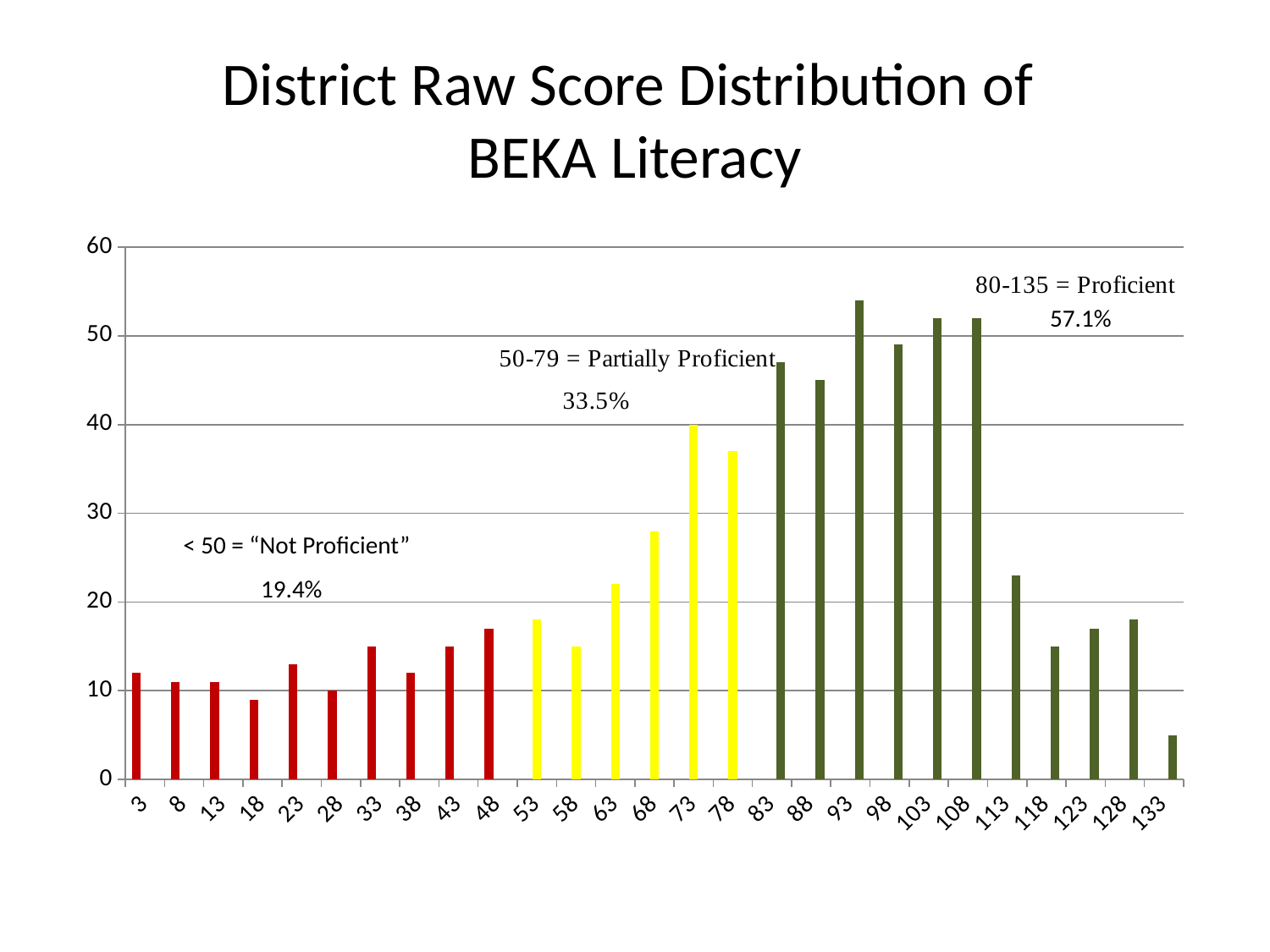
Is the value for score 68 greater or less than 20? greater Is the value for score 133 greater or less than 10? less What type of chart is shown on the slide? bar chart What is the title of the chart on the slide? District Raw Score Distribution of BEKA Literacy What percentage is shown on the chart for the 80-135 = Proficient group? 57.1% Which score category has the shortest bar? 133 Which has the larger value, score 93 or score 88? 93 Which score category has the tallest bar? 93 Is the value for score 83 greater or less than 40? greater How many bars (score categories) are plotted on the chart? 27 Which has the larger value, score 3 or score 18? 3